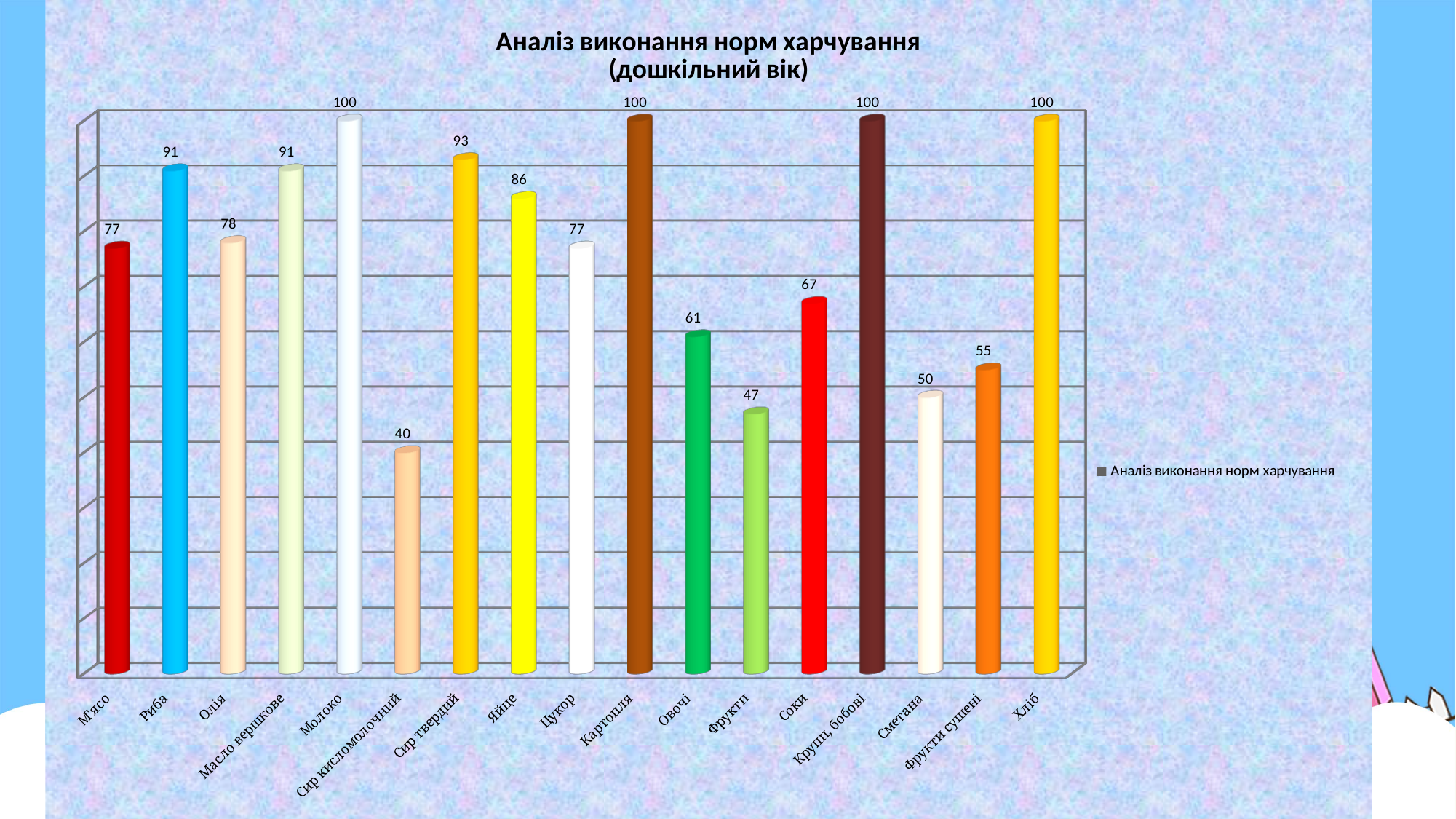
How many categories have a value of 100? 4 How many categories are shown on the x axis? 17 What is the title of the chart? Аналіз виконання норм харчування (дошкільний вік) How many series does the legend list? 1 What is the value for Сир кисломолочний? 40 Which is larger, the value for Овочі or the value for Сметана? Овочі Which category has the lowest value? Сир кисломолочний What is the difference between the values for Риба and М'ясо? 14 What is the difference between the values for Сир твердий and Фрукти? 46 What is the value for Соки? 67 What kind of chart is shown? Bar chart What is the value for Яйце? 86